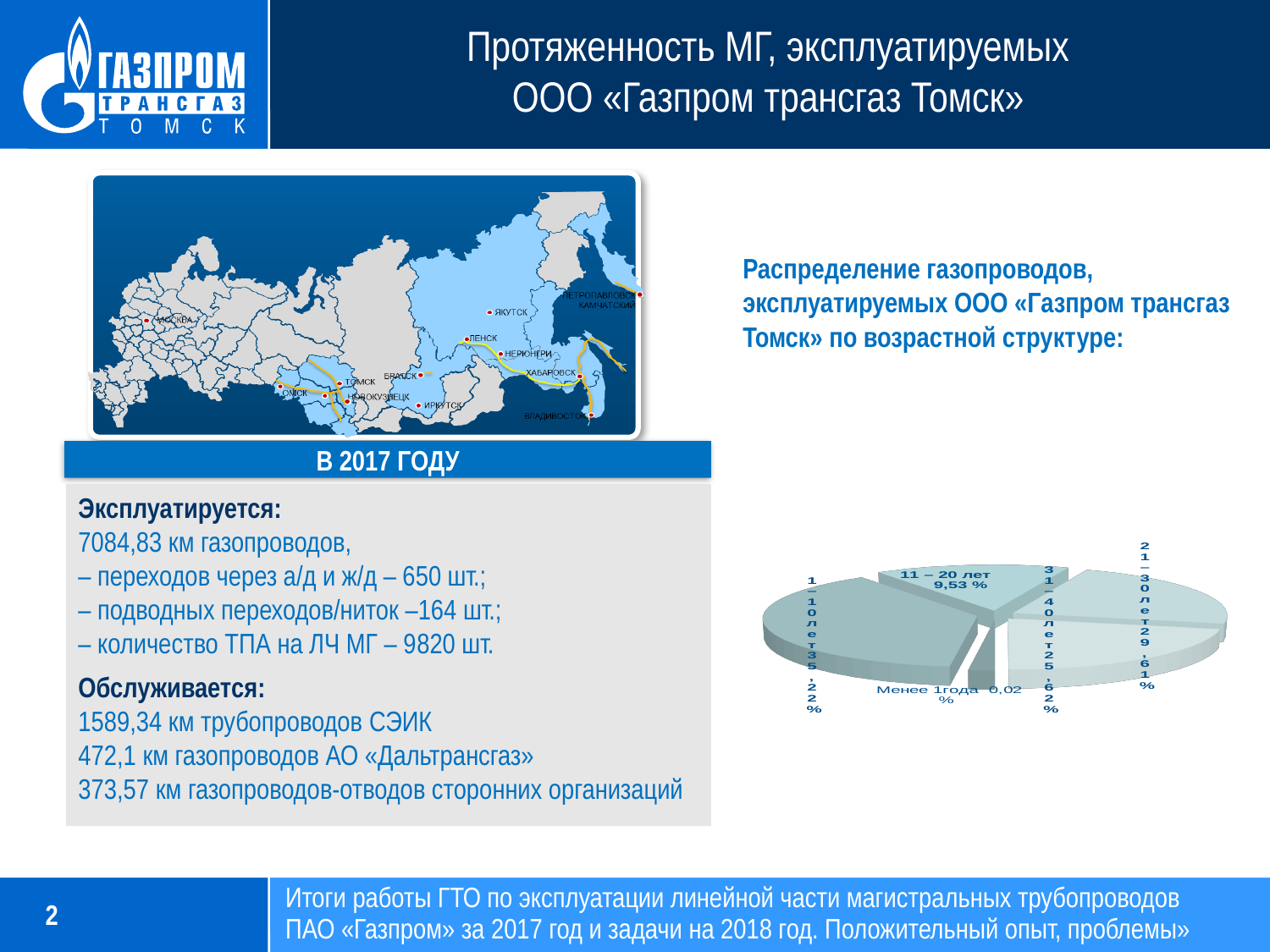
Which age group has the largest share of the pipelines? 1 – 10 лет What share of the pipelines is in the 21 – 30 лет age group? 29,61 % How many slices does the pie chart have? 5 By how many percentage points does the 1 – 10 лет share exceed the 21 – 30 лет share? 5,59 % What does the pie chart show, according to the heading next to it? Распределение газопроводов, эксплуатируемых ООО «Газпром трансгаз Томск» по возрастной структуре What share of the pipelines is less than 1 year old (Менее 1 года)? 0,02 % Which age group has the smallest share of the pipelines? Менее 1 года What share of the pipelines is in the 11 – 20 лет age group? 9,53 % What share of the pipelines is in the 31 – 40 лет age group? 25,62 % Which age group has a larger share: 21 – 30 лет or 31 – 40 лет? 21 – 30 лет What share of the pipelines is in the 1 – 10 лет age group? 35,2 % What kind of chart is shown on the slide? pie chart